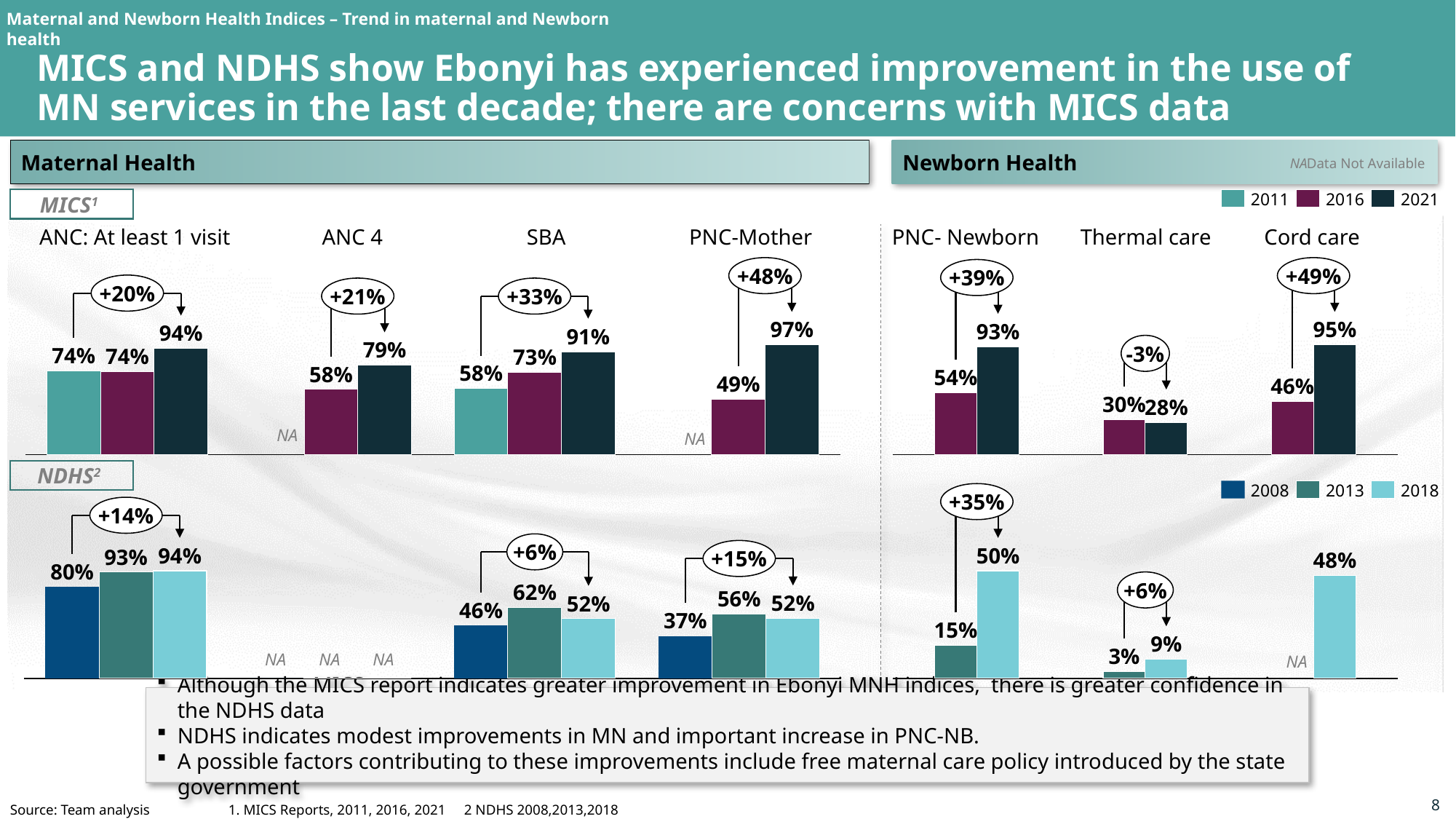
In the MICS chart for Thermal care, which is larger, the 2016 value or the 2021 value? 2016 In the MICS chart for Cord care, what is the difference between the 2021 and 2016 values? 49% What kind of chart is used to show the MICS and NDHS values on this slide? Bar chart In the MICS chart for ANC: At least 1 visit, what is the value for 2021? 94% In the MICS chart for SBA, do the values rise or fall from 2011 to 2021? Rise In the MICS chart for PNC-Mother, what is the value for 2021? 97% In the NDHS chart for PNC- Newborn, what is the value for 2018? 50% In the MICS chart for SBA, what is the value for 2016? 73% In the NDHS chart for ANC 4, what is shown for all three years? NA In the NDHS chart for SBA, which year has the highest value? 2013 In the NDHS chart for Thermal care, which year has the lowest value? 2013 How many years does the legend for the MICS charts list? 3